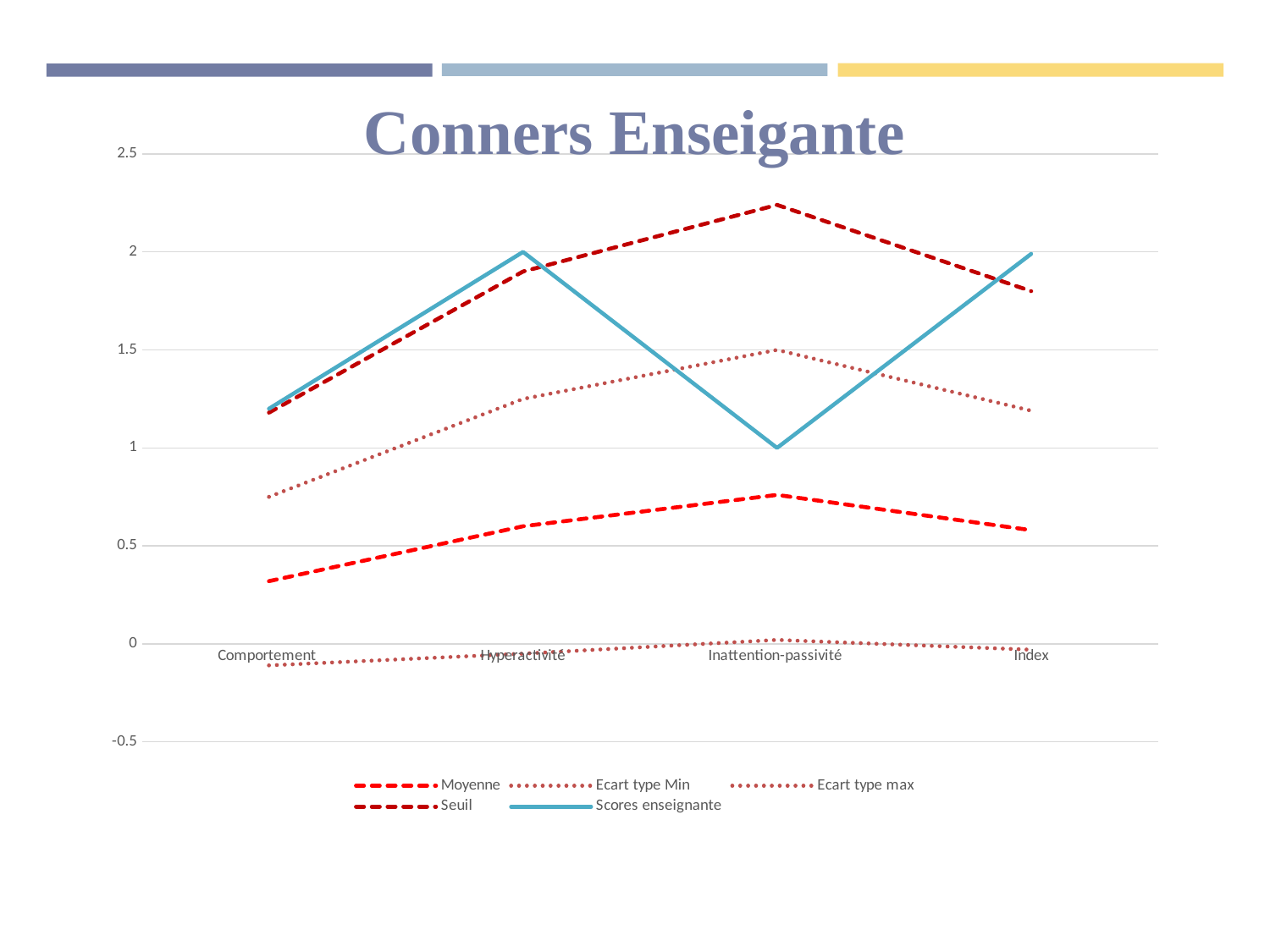
What is the title of the chart? Conners Enseigante How many categories are shown on the x axis? 4 Is the value of Seuil for Inattention-passivité greater or less than 2? greater What is the value of Scores enseignante for Inattention-passivité? 1 How many series does the legend list? 5 What is the value of Scores enseignante for Hyperactivité? 2 At Inattention-passivité, which is larger: Seuil or Scores enseignante? Seuil What kind of chart is shown on the slide? line chart For which category is Seuil highest? Inattention-passivité Is the value of Moyenne for Comportement greater or less than 0.5? less For which category is Scores enseignante lowest? Inattention-passivité Does Moyenne rise or fall from Comportement to Inattention-passivité? rise